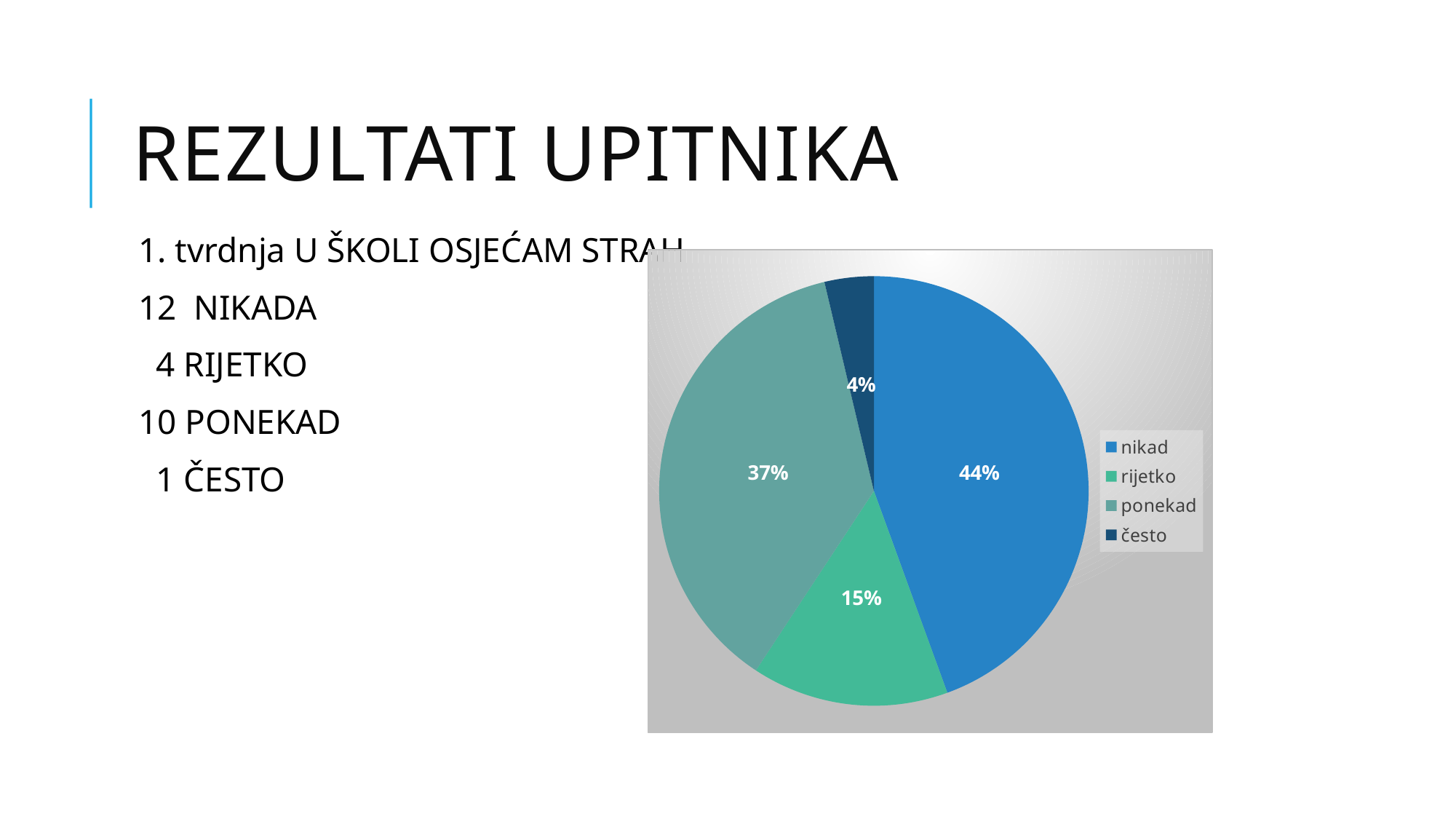
What percentage of the pie does the 'nikad' slice represent? 44% Which category has the smallest slice of the pie? često What percentage of the pie does the 'rijetko' slice represent? 15% What percentage of the pie does the 'često' slice represent? 4% Which slice is larger, 'rijetko' or 'ponekad'? ponekad How many entries does the legend list? 4 Which category has the largest slice of the pie? nikad What percentage of the pie does the 'ponekad' slice represent? 37% What colour is the 'rijetko' slice in the pie chart? green What kind of chart is shown on the slide? pie chart How many slices does the pie chart have? 4 What is the difference in percentage points between the 'nikad' and 'ponekad' slices? 7